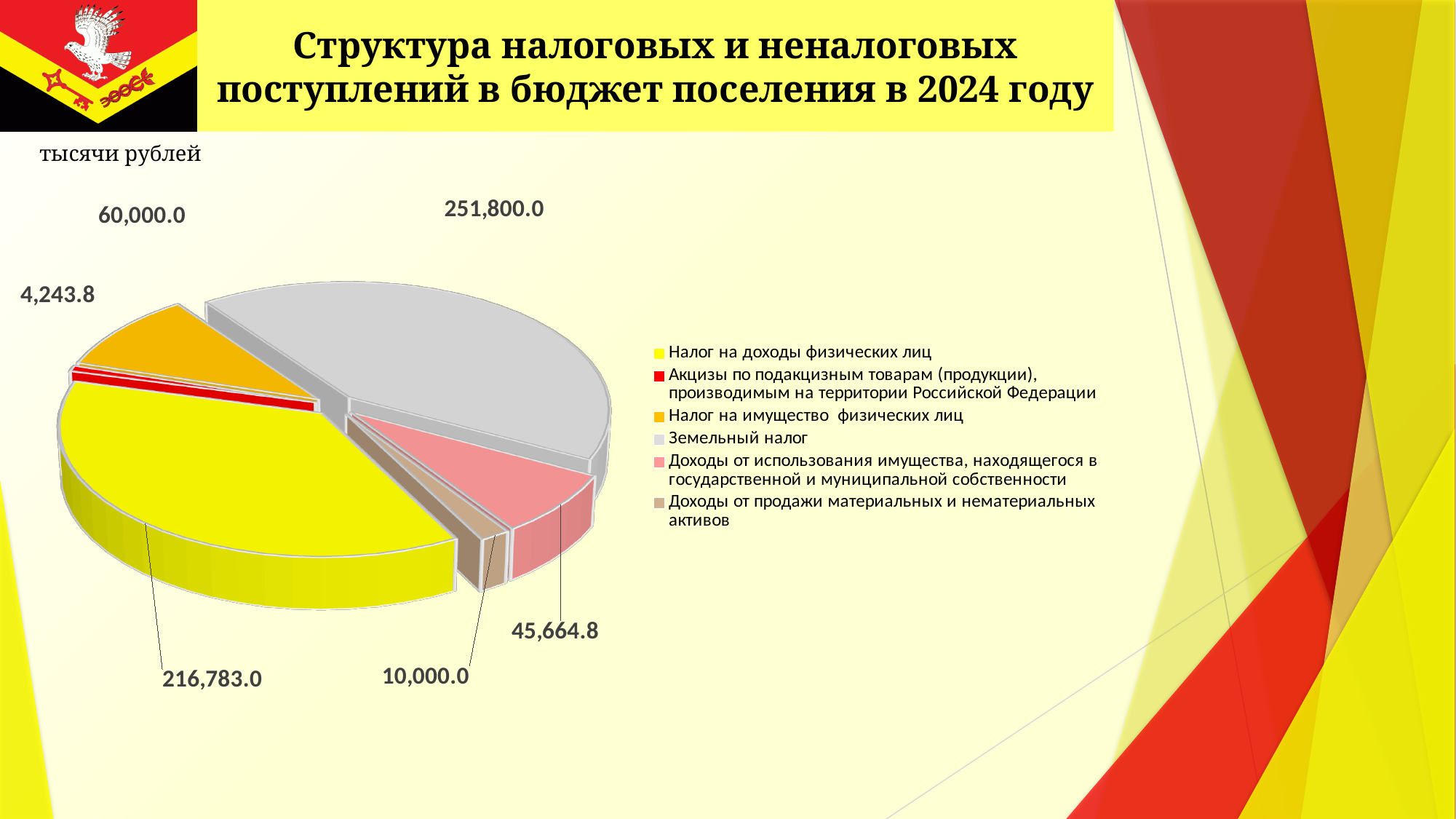
What is the value for Акцизы по подакцизным товарам (продукции), производимым на территории Российской Федерации? 4,243.8 Which category has the smallest slice of the pie? Акцизы по подакцизным товарам (продукции), производимым на территории Российской Федерации What unit is stated for the values in the chart? тысячи рублей What is the value for Налог на доходы физических лиц? 216,783.0 How many categories does the pie chart have? 6 What is the value for Земельный налог? 251,800.0 What is the value for Налог на имущество физических лиц? 60,000.0 Which category has the largest slice of the pie? Земельный налог What is the difference between the values for Земельный налог and Налог на доходы физических лиц? 35,017.0 What type of chart is shown on the slide? Pie chart What is the value for Доходы от продажи материальных и нематериальных активов? 10,000.0 Which is larger: Налог на имущество физических лиц or Доходы от использования имущества, находящегося в государственной и муниципальной собственности? Налог на имущество физических лиц